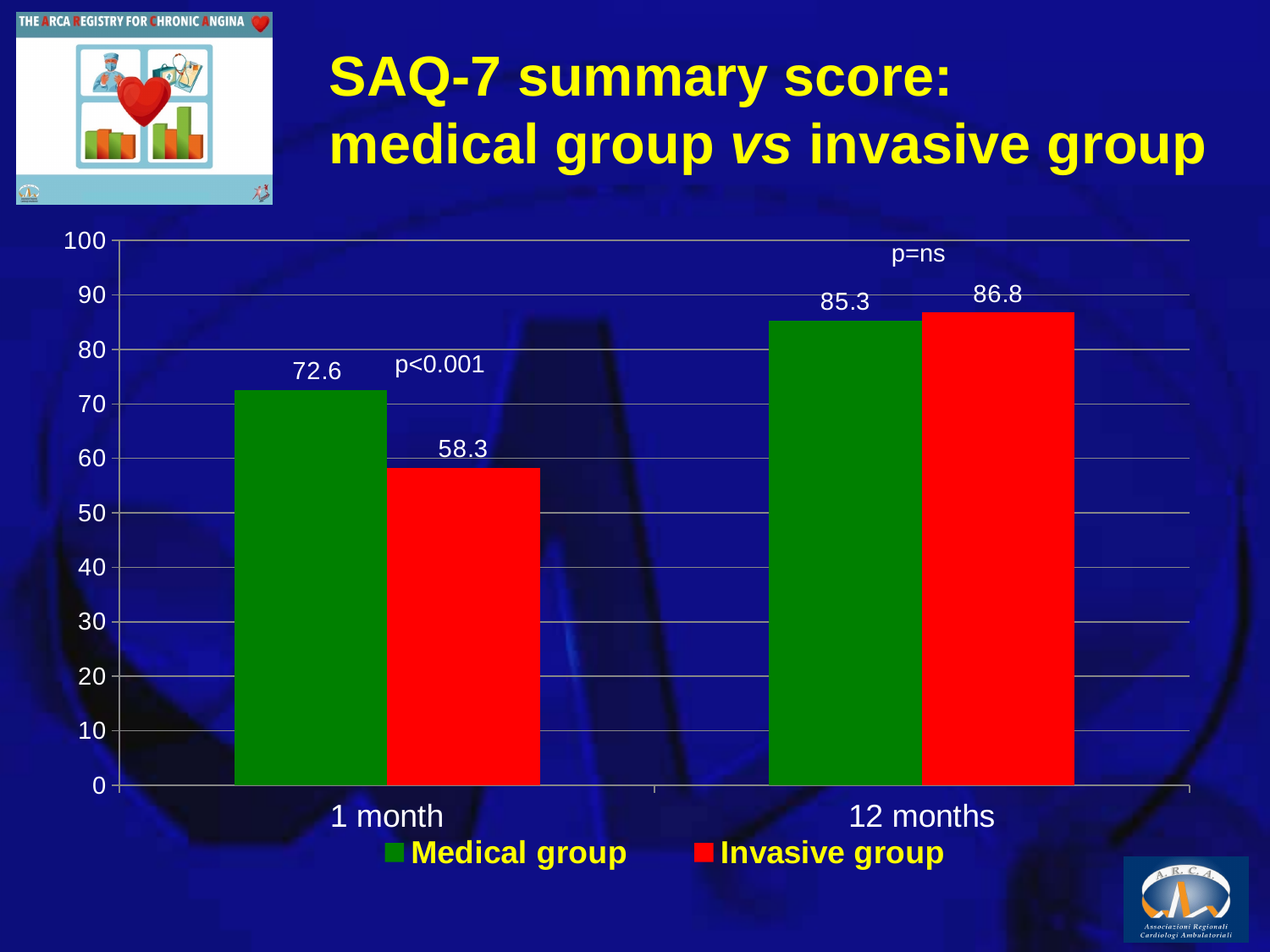
At 1 month, which group has the higher SAQ-7 summary score? Medical group How many time-point categories are shown on the x axis? 2 What kind of chart is shown on the slide? Bar chart What is the difference between the Invasive group and Medical group scores at 12 months? 1.5 What is the difference between the Medical group and Invasive group scores at 1 month? 14.3 What is the SAQ-7 summary score for the Invasive group at 1 month? 58.3 Does the Invasive group score rise or fall from 1 month to 12 months? Rise How many series does the legend list? 2 What is the SAQ-7 summary score for the Invasive group at 12 months? 86.8 What is the SAQ-7 summary score for the Medical group at 1 month? 72.6 What is the SAQ-7 summary score for the Medical group at 12 months? 85.3 Which group and time point has the lowest SAQ-7 summary score? Invasive group at 1 month